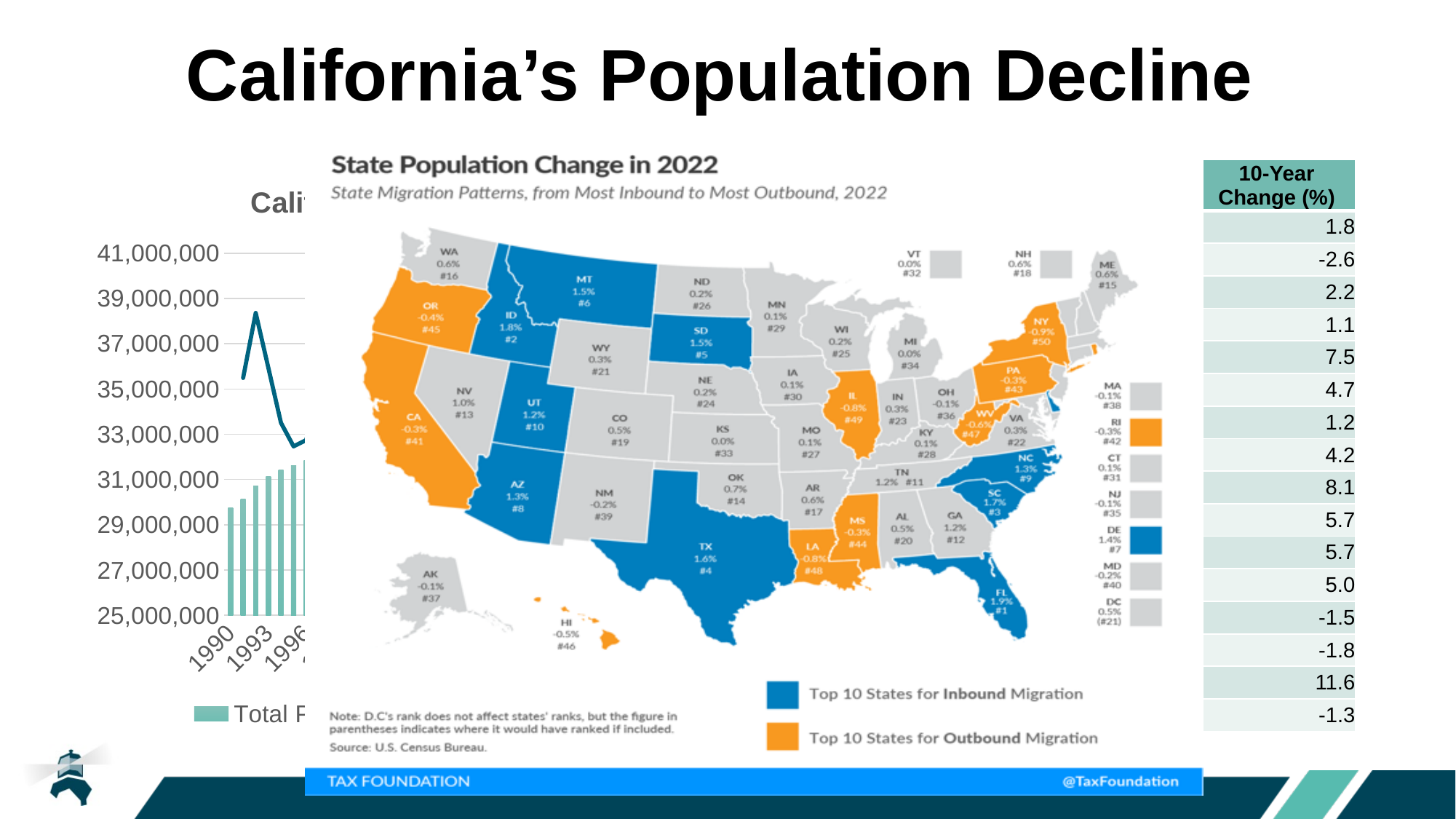
On the 'State Population Change in 2022' map, what is the population change shown for CA? -0.3% What is the highest value shown on the y-axis of the left chart? 41,000,000 What kind of chart is the partially visible chart on the left of the slide? bar chart with a line On the left chart, is the bar for 1990 greater or less than 29,000,000? greater What is the lowest value shown on the y-axis of the left chart? 25,000,000 On the 'State Population Change in 2022' map, what do the blue states represent? Top 10 States for Inbound Migration On the left chart, is the bar for 1990 greater or less than 31,000,000? less In the '10-Year Change (%)' table on the right, what is the highest value listed? 11.6 On the 'State Population Change in 2022' map, which state is ranked #50? NY On the 'State Population Change in 2022' map, which state is ranked #1? FL On the left chart, do the bars rise or fall from 1990 to 1996? rise On the 'State Population Change in 2022' map, what rank is CA given? #41